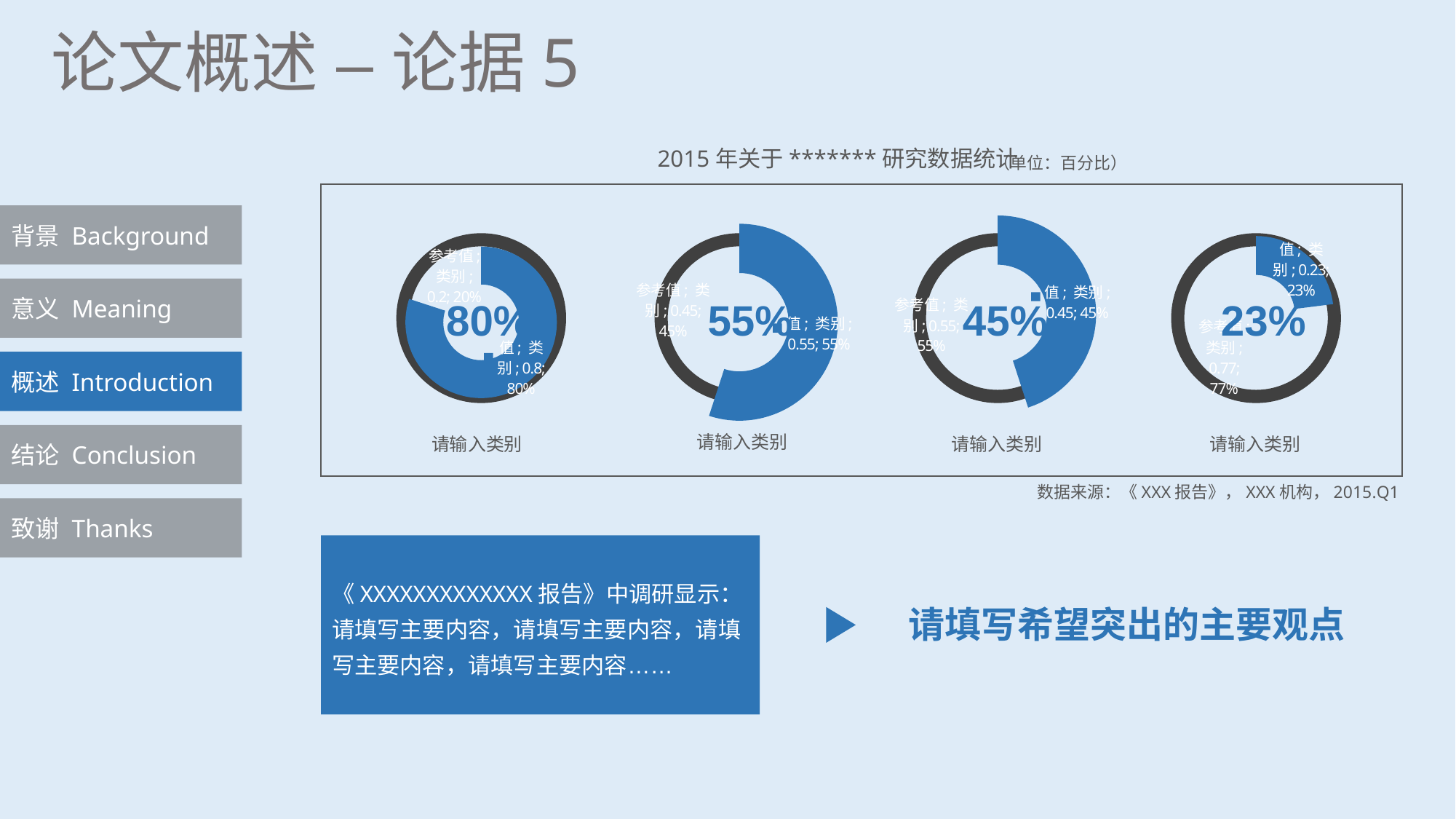
In the rightmost doughnut chart, what percentage is shown in the centre? 23% What kind of chart is used for each of the four charts on the slide? Doughnut (pie) chart Which of the four doughnut charts shows the highest centre percentage? The leftmost chart (80%) What is the difference between the centre percentage of the leftmost chart and that of the rightmost chart? 57 percentage points In the third doughnut chart from the left, what percentage is shown in the centre? 45% Which of the four doughnut charts shows the lowest centre percentage? The rightmost chart (23%) How many doughnut charts are shown on the slide? 4 In the leftmost doughnut chart, what percentage is shown in the centre? 80% In the second doughnut chart from the left, what percentage is shown in the centre? 55% In the rightmost doughnut chart, what share does the 参考值 slice have? 77% In the leftmost doughnut chart, what share does the 参考值 slice have? 20% Which has the larger centre percentage, the second doughnut chart or the third doughnut chart? The second chart (55%)